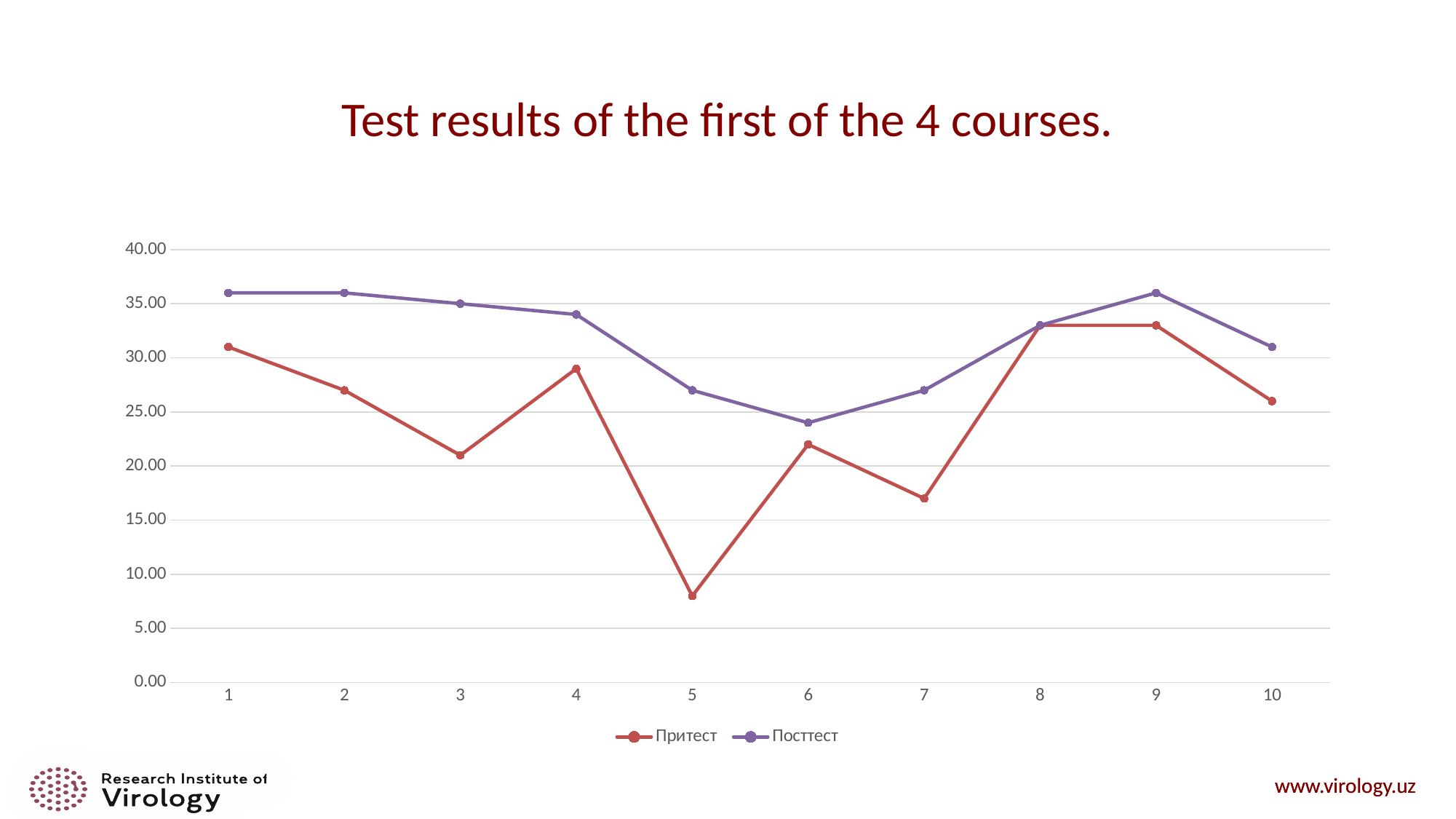
How many points are plotted along the x axis for each series? 10 How many series does the legend list? 2 At which x-axis point does the Посттест series reach its lowest value? 6 Is the Посттест value at point 6 greater or less than 25.00? less Is the Притест value at point 3 greater or less than 25.00? less What is the title of the chart? Test results of the first of the 4 courses. At which x-axis point does the Притест series reach its lowest value? 5 Does the Посттест series rise or fall from point 1 to point 6? fall At point 5, which series has the higher value, Притест or Посттест? Посттест What kind of chart is shown on the slide? line chart Is the Посттест value at point 1 greater or less than 35.00? greater